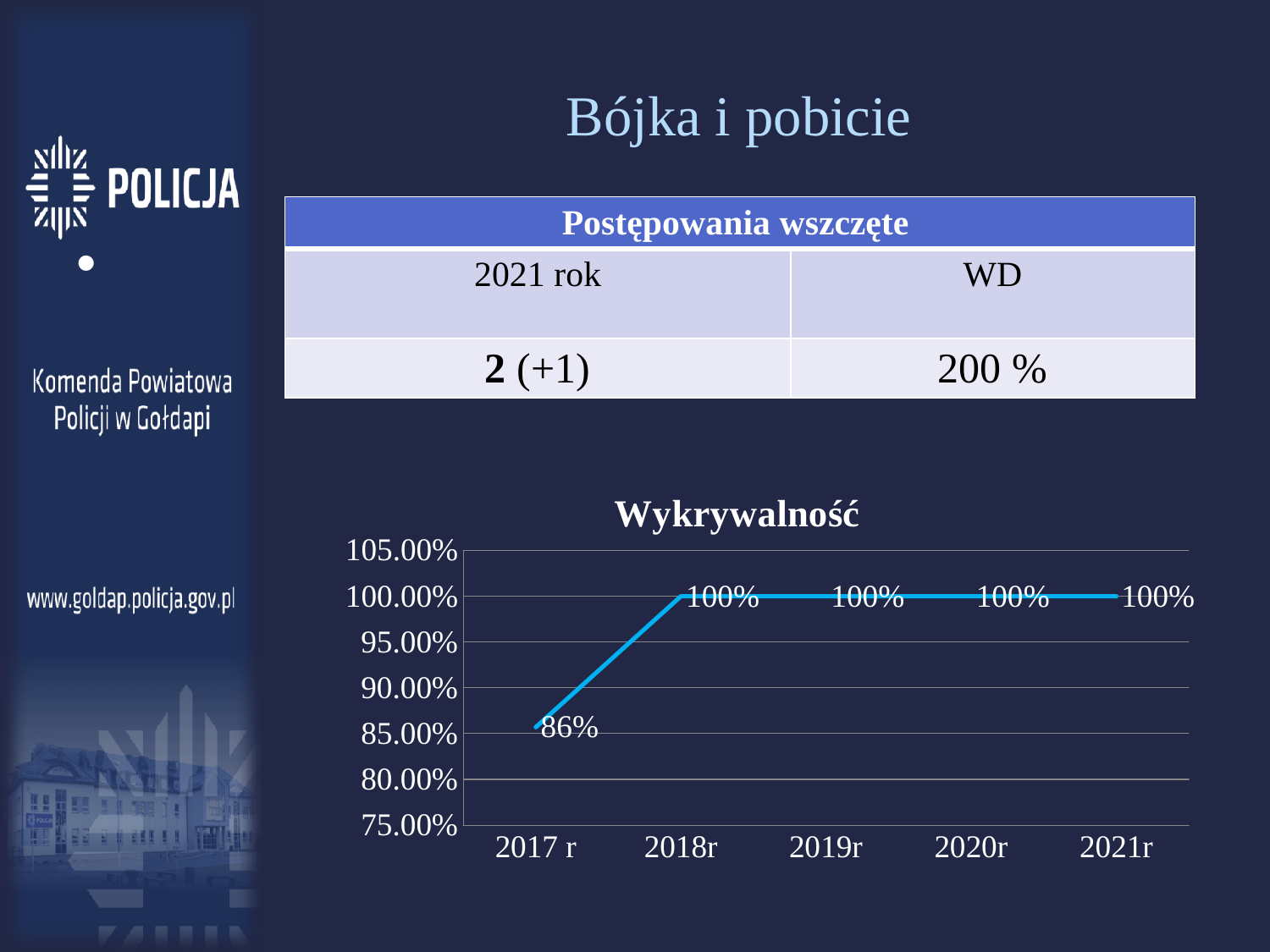
What is the value plotted for 2017 r in the Wykrywalność chart? 86% Does the line in the Wykrywalność chart rise or fall between 2017 r and 2018r? rise What is the lowest value shown on the vertical axis of the Wykrywalność chart? 75.00% What type of chart is shown under the title "Wykrywalność"? line chart In the Wykrywalność chart, which is larger: the value for 2017 r or the value for 2019r? 2019r What is the value plotted for 2018r in the Wykrywalność chart? 100% How many data points are plotted in the Wykrywalność chart? 5 What is the title of the chart on the slide? Wykrywalność What is the value plotted for 2021r in the Wykrywalność chart? 100% What is the difference between the values for 2018r and 2017 r in the Wykrywalność chart? 14% Is the value for 2017 r in the Wykrywalność chart greater or less than 90.00%? less Which year has the lowest value in the Wykrywalność chart? 2017 r